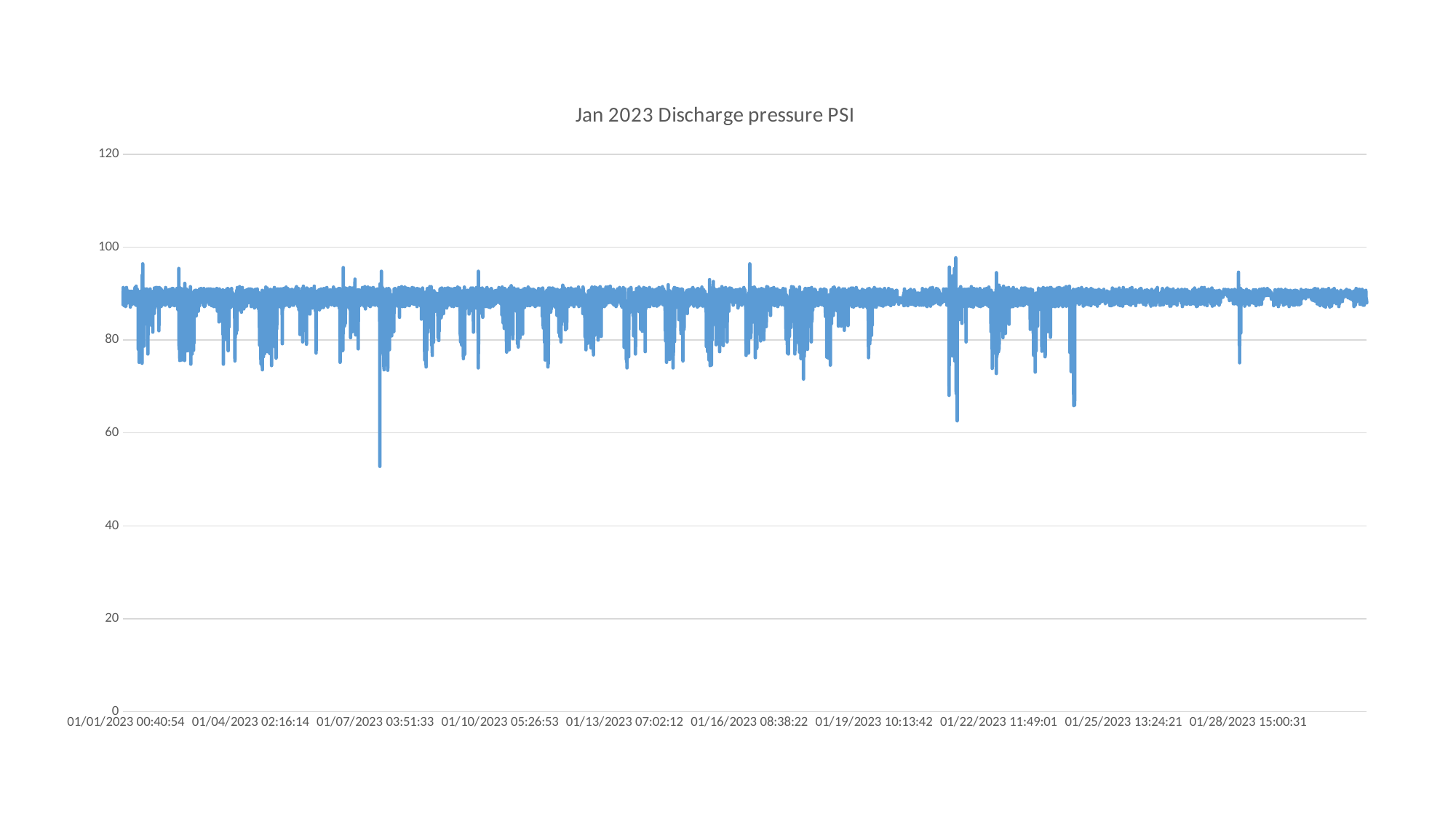
Is the value at the start of the series (01/01/2023) greater or less than 80? greater Is the value at the end of the series (late January 2023) greater or less than 80? greater What is the highest value shown on the vertical axis? 120 Does the discharge pressure show a strong rising or falling trend across January 2023, or does it stay roughly level? roughly level What is the title of the chart? Jan 2023 Discharge pressure PSI Is the highest value reached by the line greater or less than 100? less What kind of chart is shown on the slide? line chart